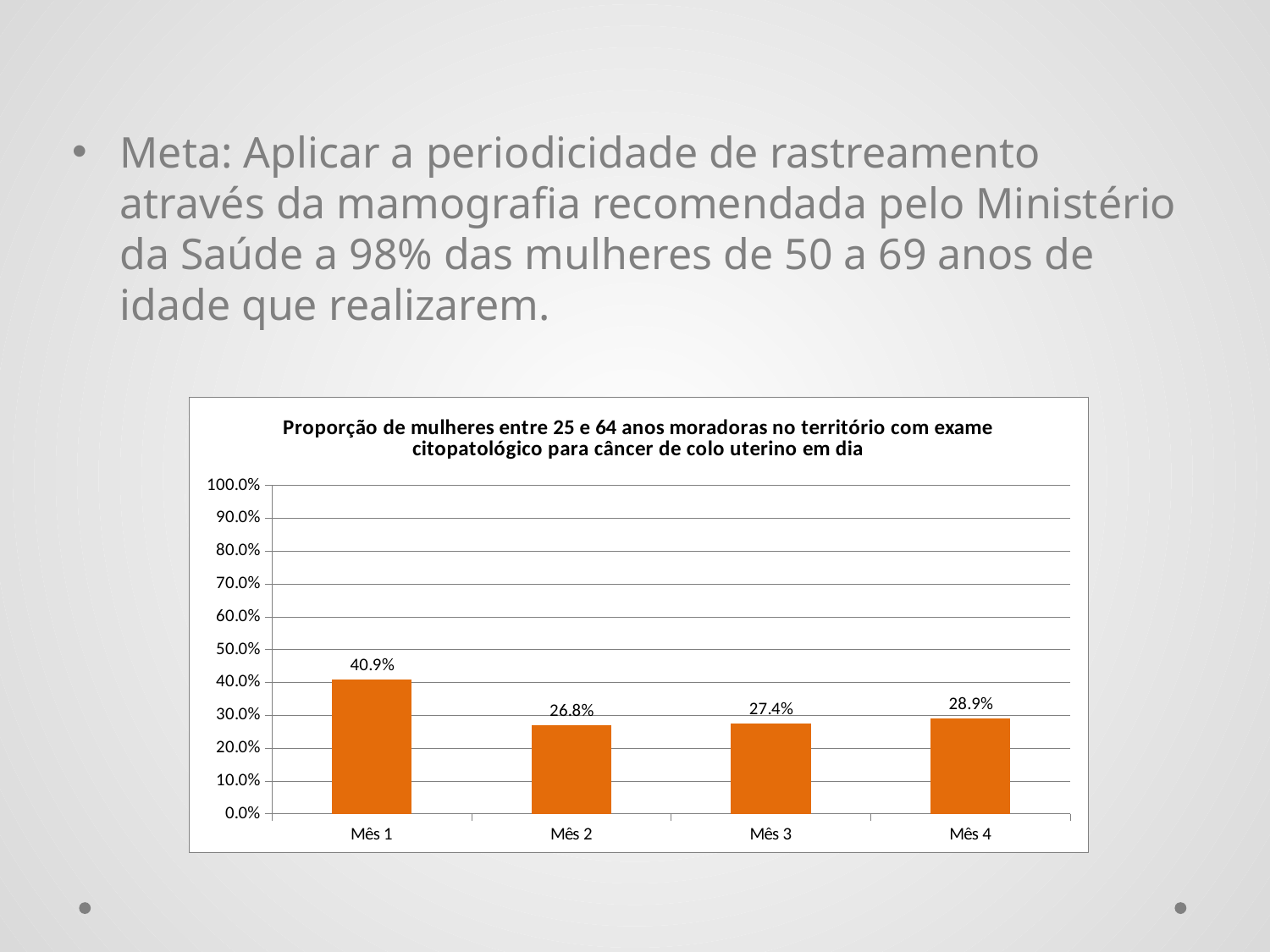
What is the value for Mês 4? 28.9% Which month has the highest value? Mês 1 What is the value for Mês 3? 27.4% Which is larger, the value for Mês 1 or the value for Mês 4? Mês 1 What is the title of the chart? Proporção de mulheres entre 25 e 64 anos moradoras no território com exame citopatológico para câncer de colo uterino em dia What is the value for Mês 1? 40.9% What is the difference between the values for Mês 1 and Mês 2? 14.1% Which month has the lowest value? Mês 2 What kind of chart is shown on the slide? Bar chart What is the difference between the values for Mês 4 and Mês 3? 1.5% How many months are shown on the x axis? 4 What is the value for Mês 2? 26.8%